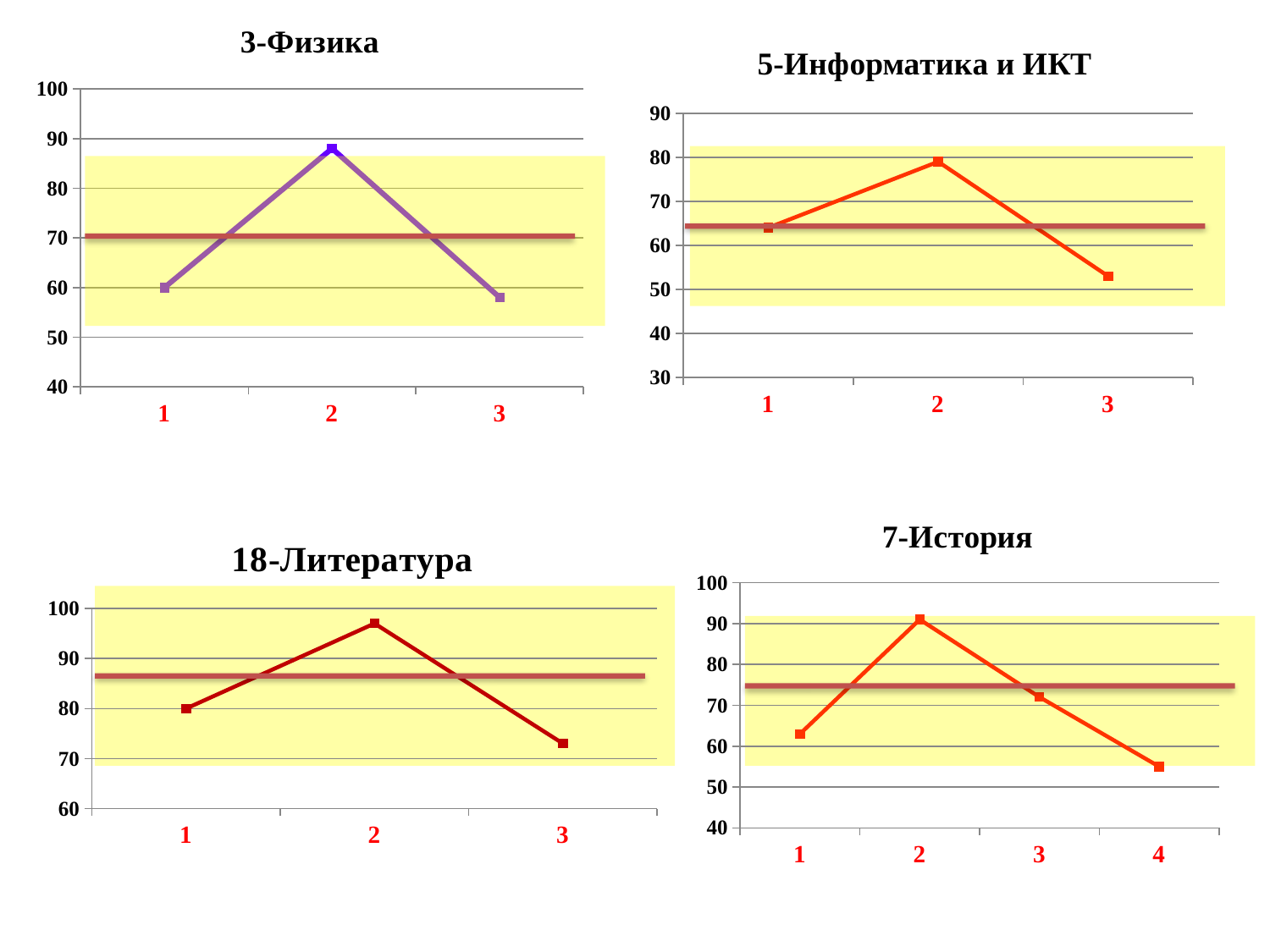
In the "3-Физика" chart, is the value for category 2 greater or less than 80? greater What kind of chart is the "3-Физика" chart? line chart In the "3-Физика" chart, which category has the highest value? 2 In the "18-Литература" chart, what is the value for category 1? 80 In the "18-Литература" chart, do the values rise or fall from category 2 to category 3? fall How many categories are shown on the x axis of the "7-История" chart? 4 What is the title of the chart in the top-right of the slide? 5-Информатика и ИКТ In the "5-Информатика и ИКТ" chart, is the value for category 3 greater or less than 60? less In the "7-История" chart, which category has the lowest value? 4 In the "5-Информатика и ИКТ" chart, which is larger, the value for category 1 or category 2? category 2 How many categories are shown on the x axis of the "18-Литература" chart? 3